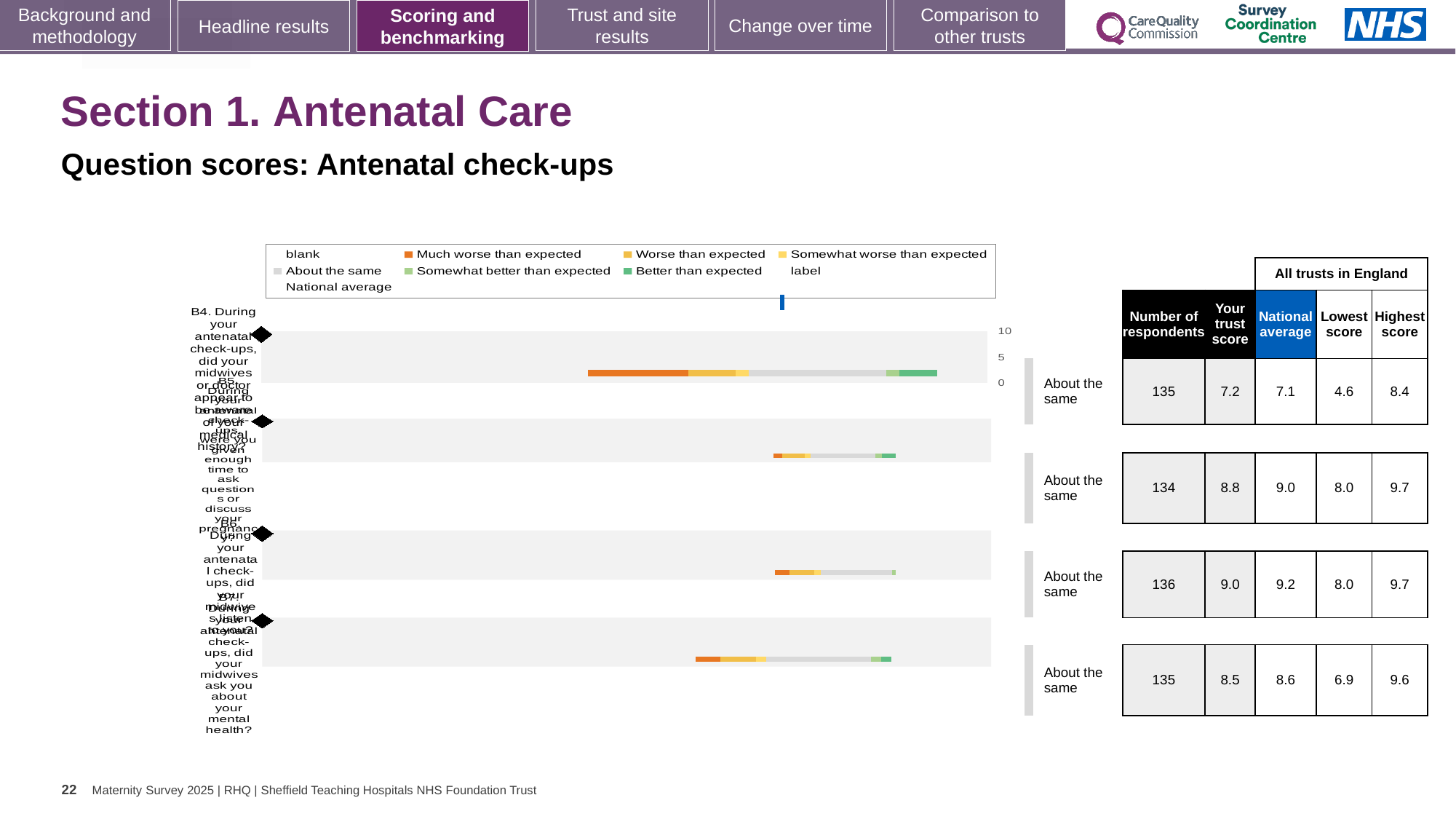
In the table next to the chart, what is the number of respondents for the last question (B7, midwives asked about mental health)? 135 In the table next to the chart, what is the difference between the highest score and the lowest score for the first question row (B4)? 3.8 In the table next to the chart, what is the national average for the third question row? 9.2 What is the highest value shown on the chart's axis? 10 In the table next to the chart, for the third question row, which is larger: the trust score or the national average? National average (9.2) Which colour does the legend use for 'Much worse than expected'? orange What benchmark category is shown beside each of the four question bars? About the same How many legend entries does the chart's legend list? 9 What kind of chart is shown on the slide? bar chart How many question bars are plotted in the chart? 4 In the table next to the chart, what is the 'Your trust score' for the first question (B4, midwives or doctor aware of medical history)? 7.2 In the table next to the chart, which question row has the lowest 'Your trust score'? B4 (first row), 7.2